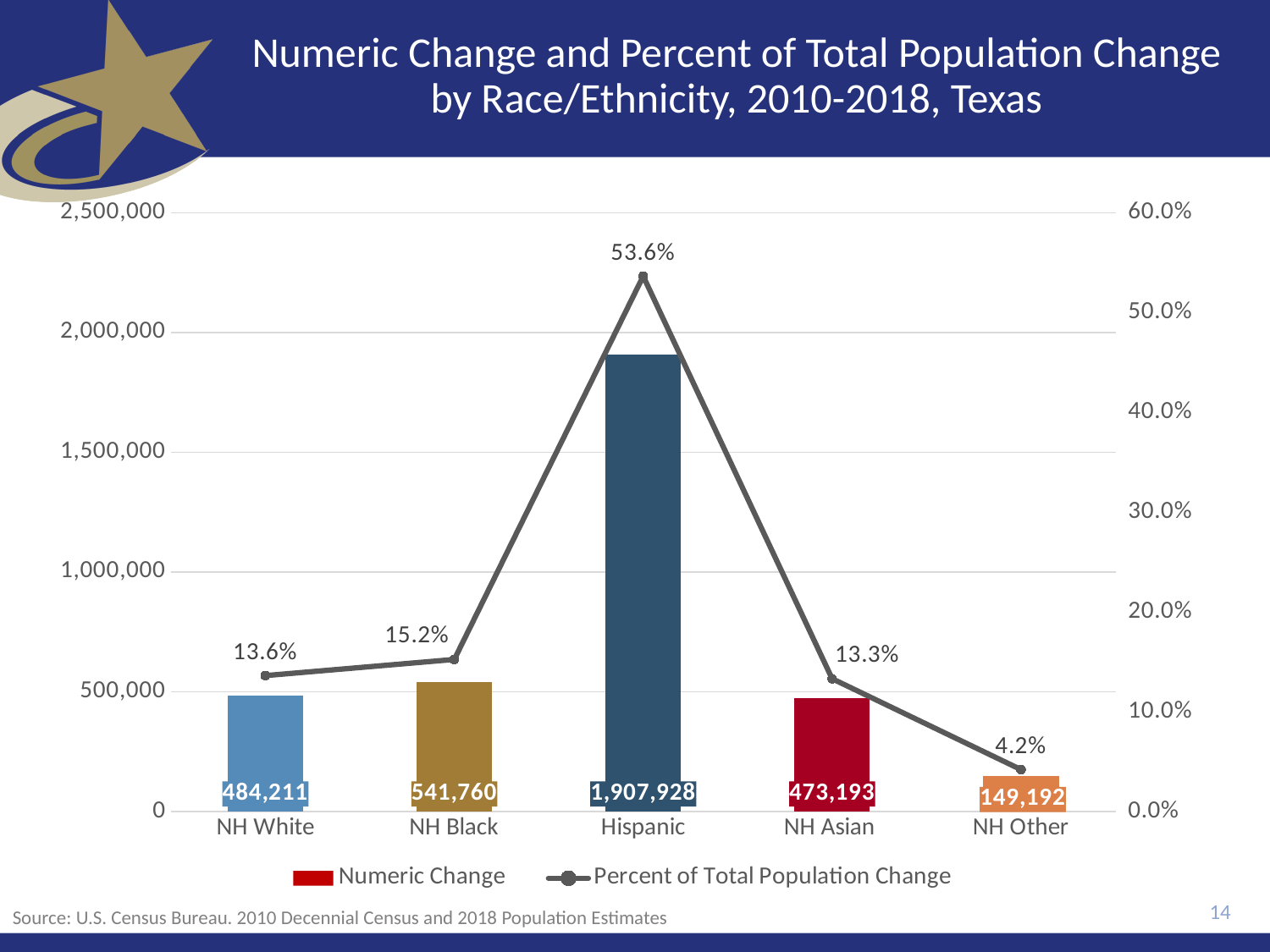
Which race/ethnicity group has the lowest Percent of Total Population Change? NH Other What is the Numeric Change for NH Other? 149,192 How many race/ethnicity categories are shown on the x axis? 5 Which has a larger Numeric Change, NH White or NH Asian? NH White What is the Numeric Change for Hispanic? 1,907,928 Is the Numeric Change for Hispanic greater or less than 2,000,000? less Which race/ethnicity group has the highest Numeric Change? Hispanic What is the Percent of Total Population Change for NH Black? 15.2% What is the difference in Numeric Change between NH Black and NH White? 57,549 How many series does the legend list? 2 What is the difference in Percent of Total Population Change between Hispanic and NH White? 40.0% What is the Percent of Total Population Change for NH Asian? 13.3%